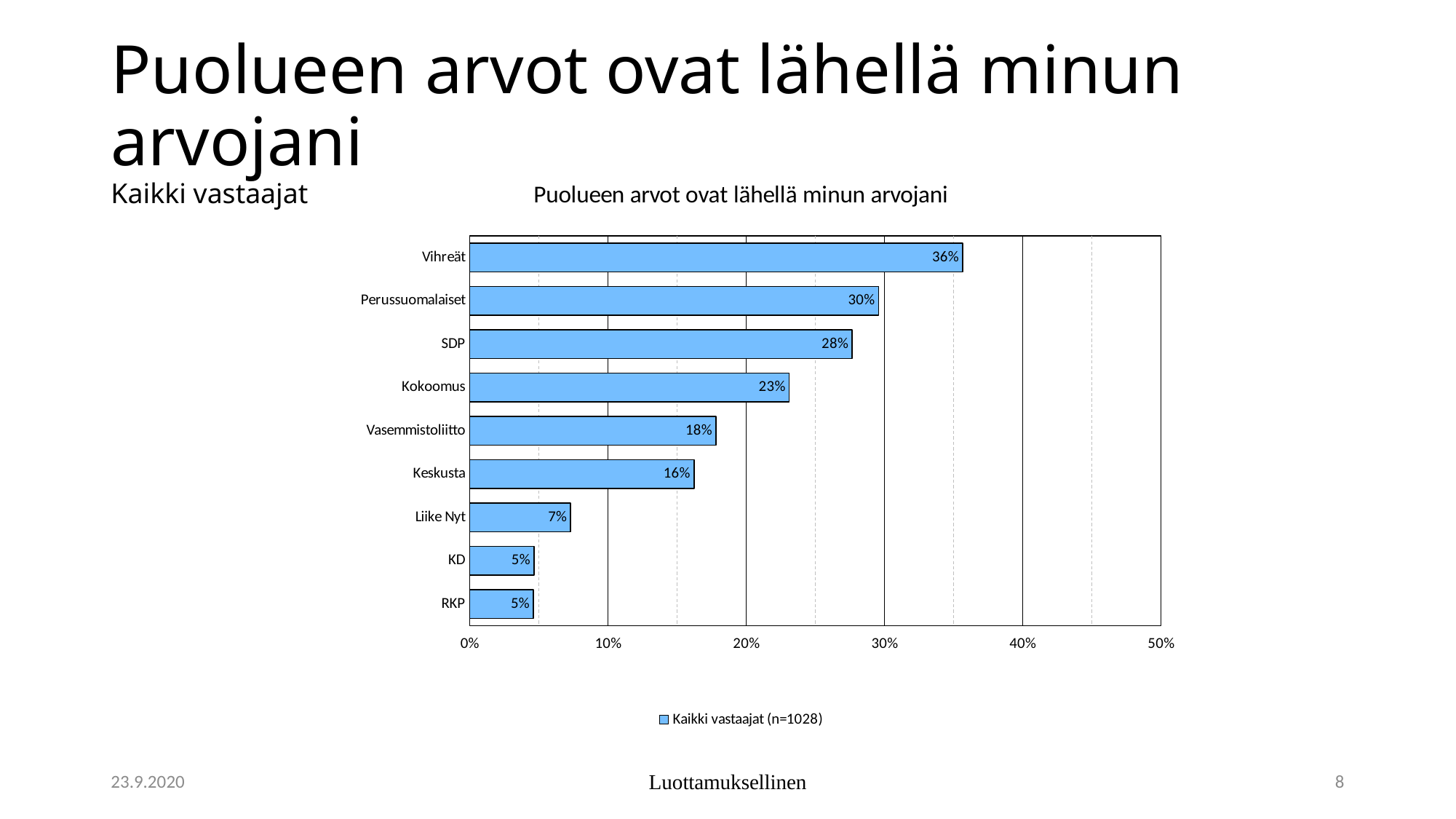
What is the difference between the values for Perussuomalaiset and SDP? 2% What is the difference between the values for Vihreät and Liike Nyt? 29% How many series does the legend list? 1 Is the value for SDP greater or less than 20%? greater How many parties are shown in the chart? 9 What is the legend entry of the chart? Kaikki vastaajat (n=1028) What is the value for Kokoomus? 23% Which is larger, the value for Vasemmistoliitto or the value for Keskusta? Vasemmistoliitto What is the value for Keskusta? 16% What is the value for Vihreät? 36% What kind of chart is shown on the slide? Bar chart Which party has the highest value? Vihreät